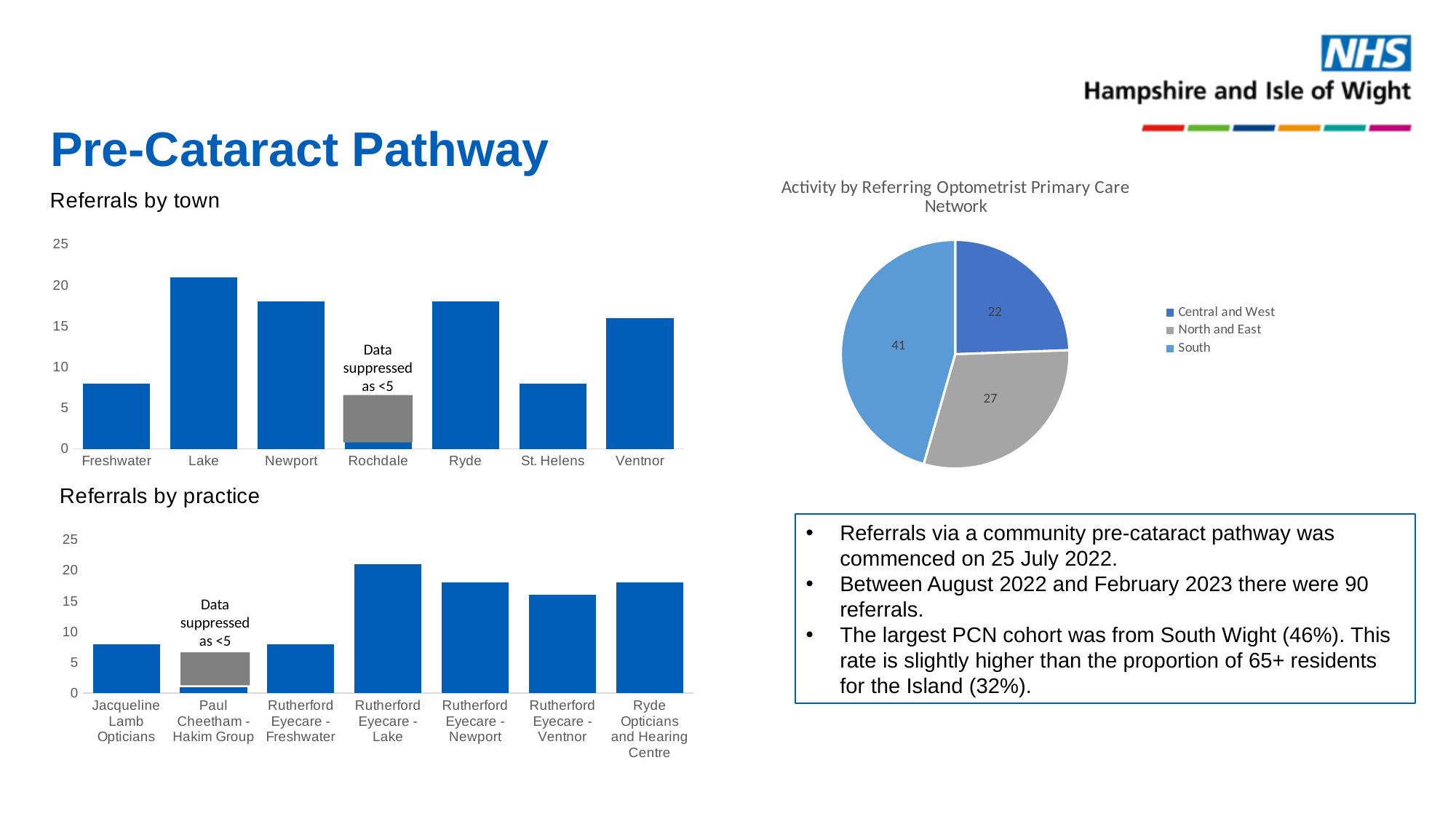
In the 'Referrals by town' chart, is the value for Ventnor greater or less than 20? less How many entries does the legend of the pie chart 'Activity by Referring Optometrist Primary Care Network' list? 3 In the pie chart 'Activity by Referring Optometrist Primary Care Network', what is the total of all three slices? 90 In the 'Referrals by town' chart, which town has the highest number of referrals? Lake In the pie chart 'Activity by Referring Optometrist Primary Care Network', how much larger is the South value than the North and East value? 14 How many practices are shown on the x axis of the 'Referrals by practice' chart? 7 In the pie chart 'Activity by Referring Optometrist Primary Care Network', which Primary Care Network has the largest slice? South In the pie chart 'Activity by Referring Optometrist Primary Care Network', which Primary Care Network has the smallest slice? Central and West In the 'Referrals by practice' chart, which practice has the highest number of referrals? Rutherford Eyecare - Lake In the pie chart 'Activity by Referring Optometrist Primary Care Network', what is the value for South? 41 What kind of chart is 'Referrals by town'? Bar chart In the pie chart 'Activity by Referring Optometrist Primary Care Network', what is the value for Central and West? 22